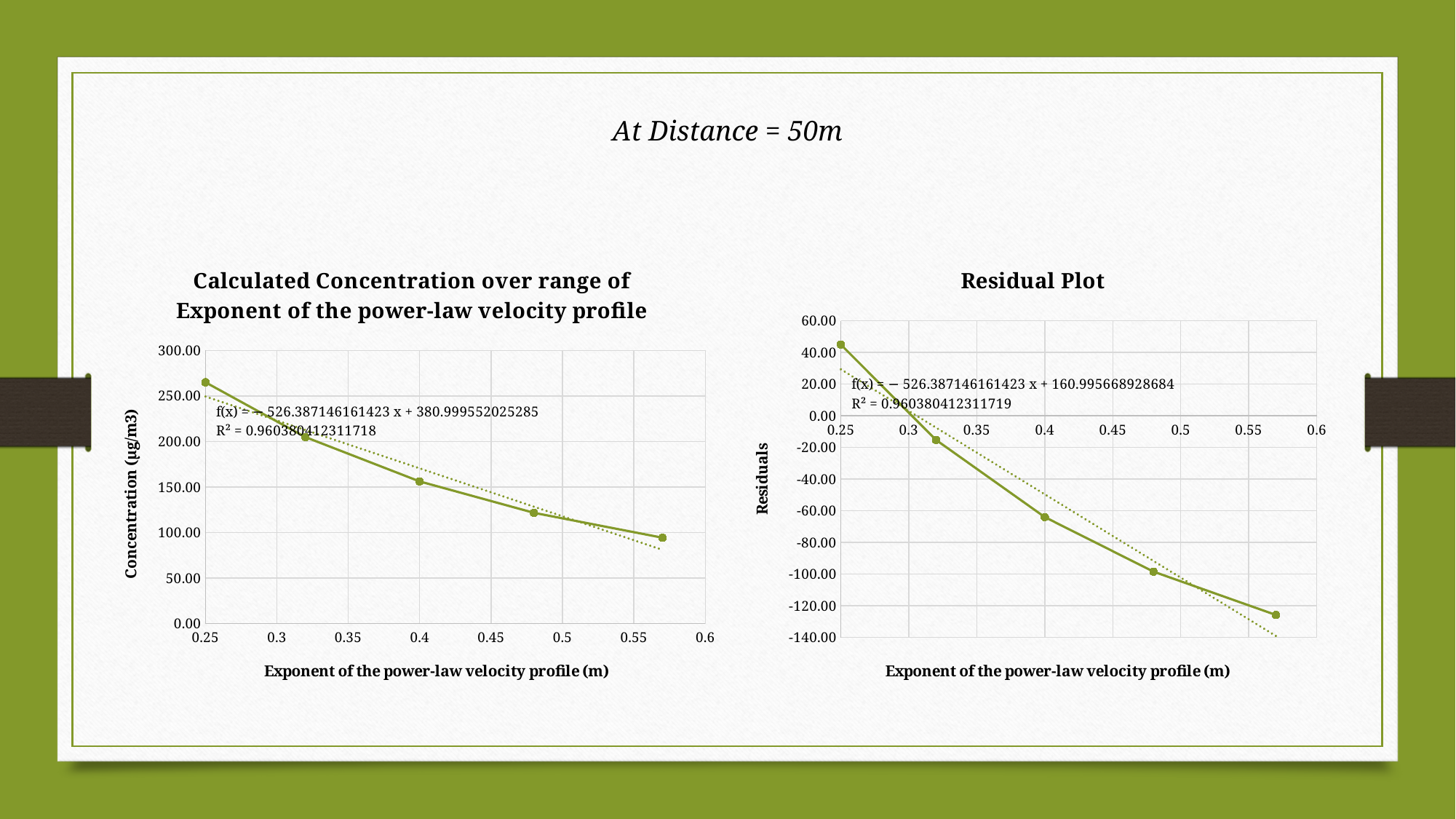
In the 'Calculated Concentration over range of Exponent of the power-law velocity profile' chart, is the concentration at exponent 0.4 greater or less than 200? less In the 'Calculated Concentration over range of Exponent of the power-law velocity profile' chart, at which exponent value is the concentration highest? 0.25 In the 'Residual Plot' chart, is the residual at exponent 0.25 greater or less than 0? greater In the 'Calculated Concentration over range of Exponent of the power-law velocity profile' chart, do the values rise or fall as the exponent increases? fall In the 'Residual Plot' chart, do the residuals rise or fall as the exponent increases? fall What is the y-axis label of the 'Calculated Concentration over range of Exponent of the power-law velocity profile' chart? Concentration (µg/m3) In the 'Residual Plot' chart, which plotted point has the lowest residual, the one at exponent 0.25 or the one at the largest exponent? the one at the largest exponent In the 'Residual Plot' chart, how many data points are plotted? 5 What R² value is shown on the 'Residual Plot' chart? 0.960380412311719 In the 'Calculated Concentration over range of Exponent of the power-law velocity profile' chart, is the concentration at exponent 0.25 greater or less than 250? greater What type of chart is the 'Calculated Concentration over range of Exponent of the power-law velocity profile' chart? line chart